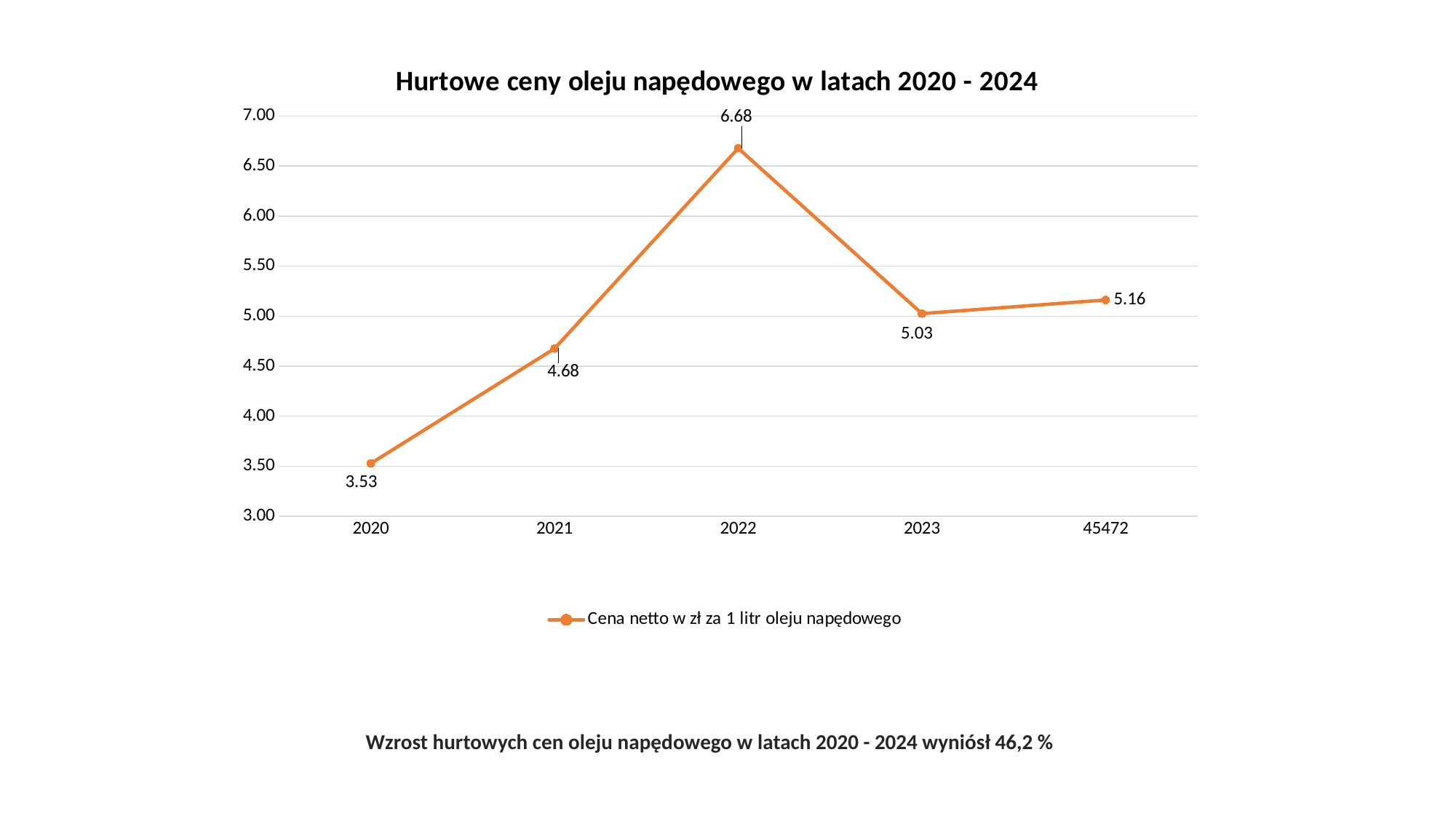
What kind of chart is shown on the slide? line chart What is the difference between the values for 2022 and 2021? 2.00 What is the value for 2022? 6.68 Which is larger, the value for 2021 or the value for 2023? 2023 Which year has the highest value? 2022 What is the value for 2023? 5.03 What is the value for 2020? 3.53 How many data points are plotted on the chart? 5 What is the title of the chart? Hurtowe ceny oleju napędowego w latach 2020 - 2024 What is the difference between the values for 2021 and 2020? 1.15 Which year has the lowest value? 2020 What is the value for the last point on the x axis, labelled 45472? 5.16